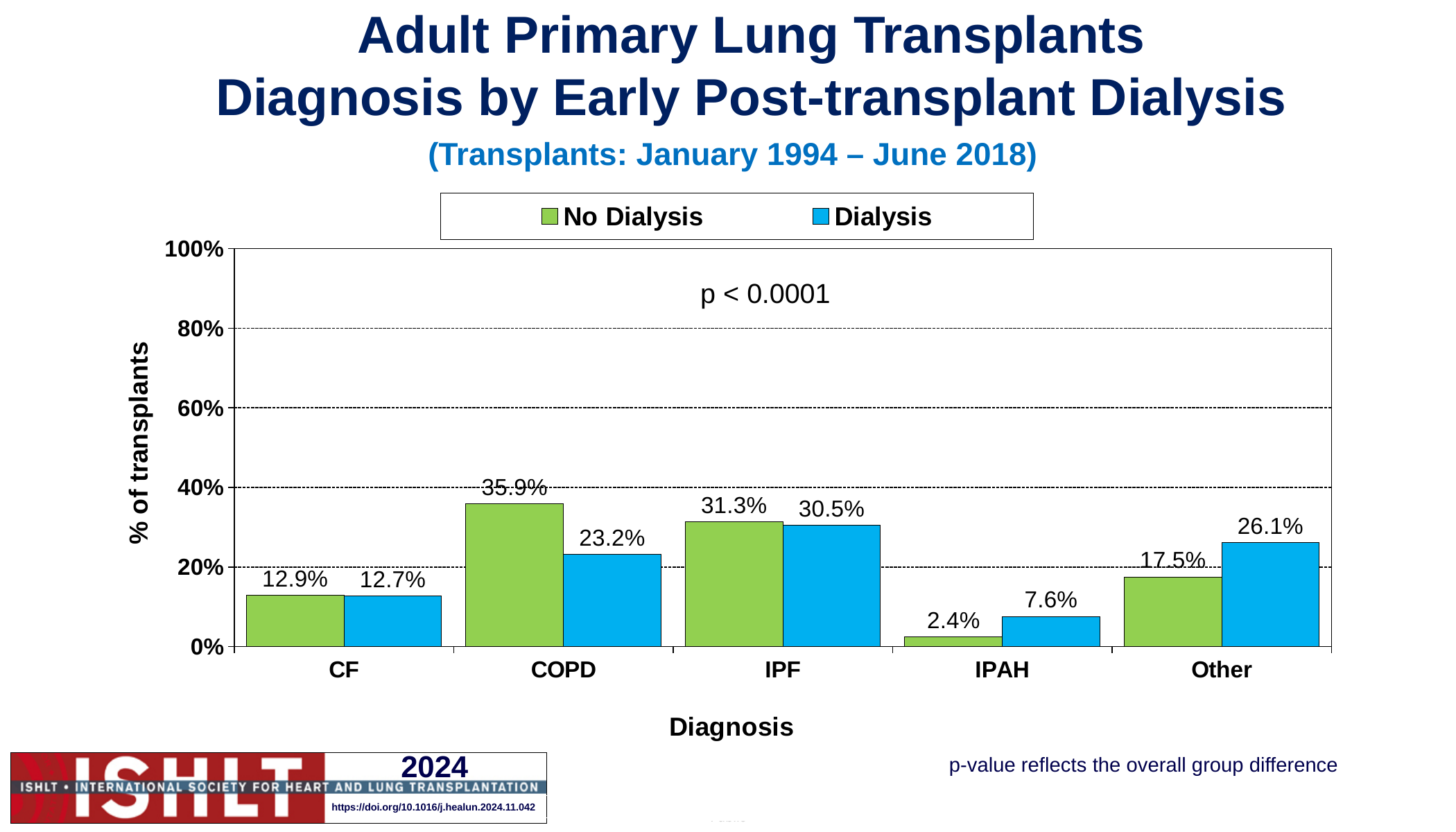
Which diagnosis has the lowest value in the Dialysis series? IPAH What is the value for COPD in the No Dialysis series? 35.9% Is the No Dialysis value for IPF greater or less than 20%? greater How many diagnosis categories are shown on the x axis? 5 What kind of chart is shown on the slide? bar chart What p-value is printed on the chart? p < 0.0001 What is the value for IPAH in the Dialysis series? 7.6% How many series does the legend list? 2 Which diagnosis has the highest value in the No Dialysis series? COPD Which is larger for Other: the No Dialysis value or the Dialysis value? Dialysis What is the value for Other in the Dialysis series? 26.1% What is the difference between the No Dialysis and Dialysis values for COPD? 12.7%